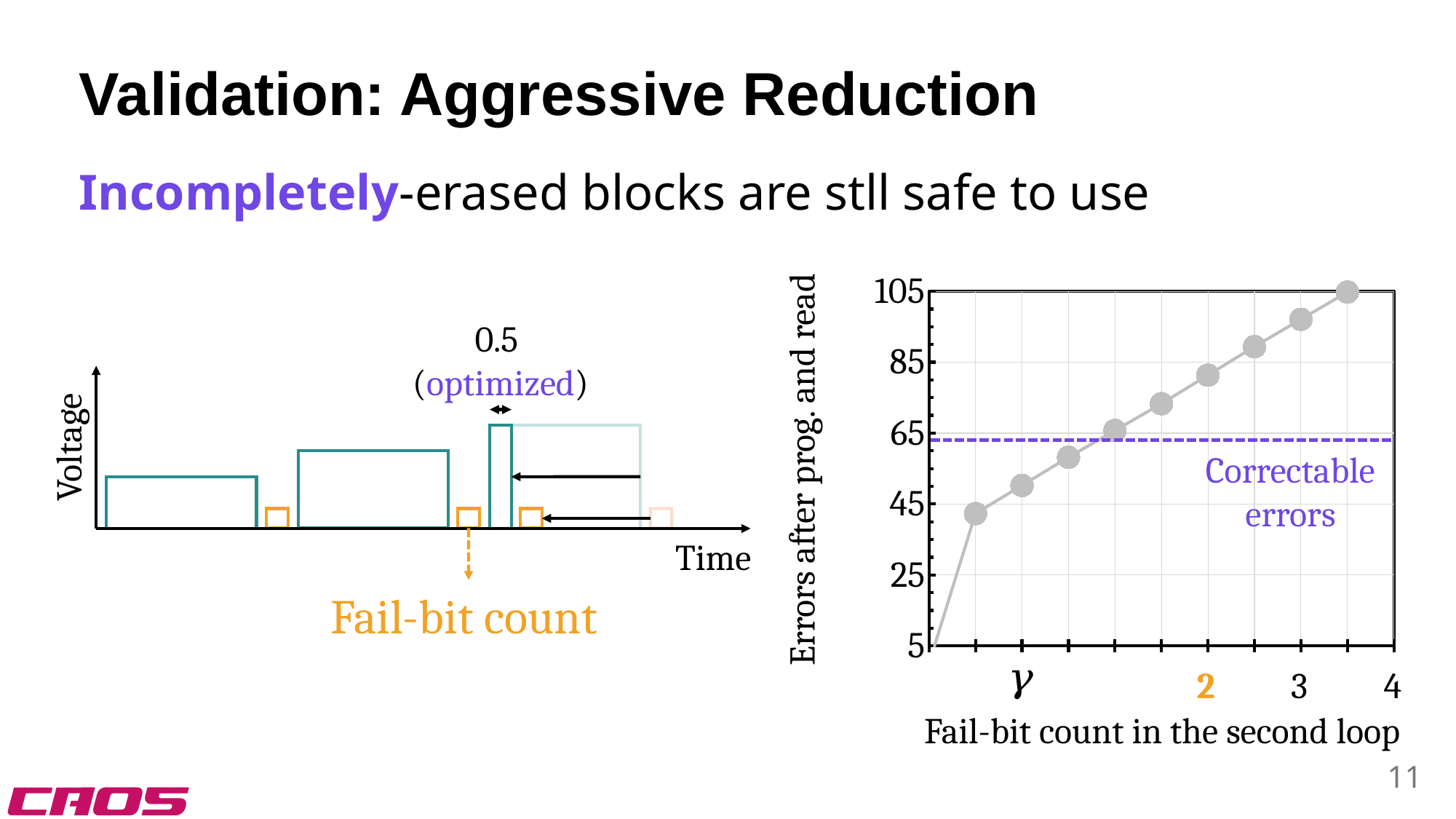
In the right-hand chart, how many data points are plotted? 9 In the right-hand chart, what is the highest value shown on the y axis? 105 What kind of chart is shown on the right side of the slide? line chart In the right-hand chart, is the value of the data point at fail-bit count 2 greater or less than 65? greater In the right-hand chart, is the value of the leftmost data point greater or less than 65? less In the right-hand chart, what is the label of the y axis? Errors after prog. and read In the right-hand chart, is the value of the rightmost data point greater or less than 85? greater In the right-hand chart, what is the label of the x axis? Fail-bit count in the second loop In the right-hand chart, which has more errors: the point at fail-bit count 3 or the point at fail-bit count 2? 3 In the right-hand chart, do the errors rise or fall as the fail-bit count in the second loop increases? rise